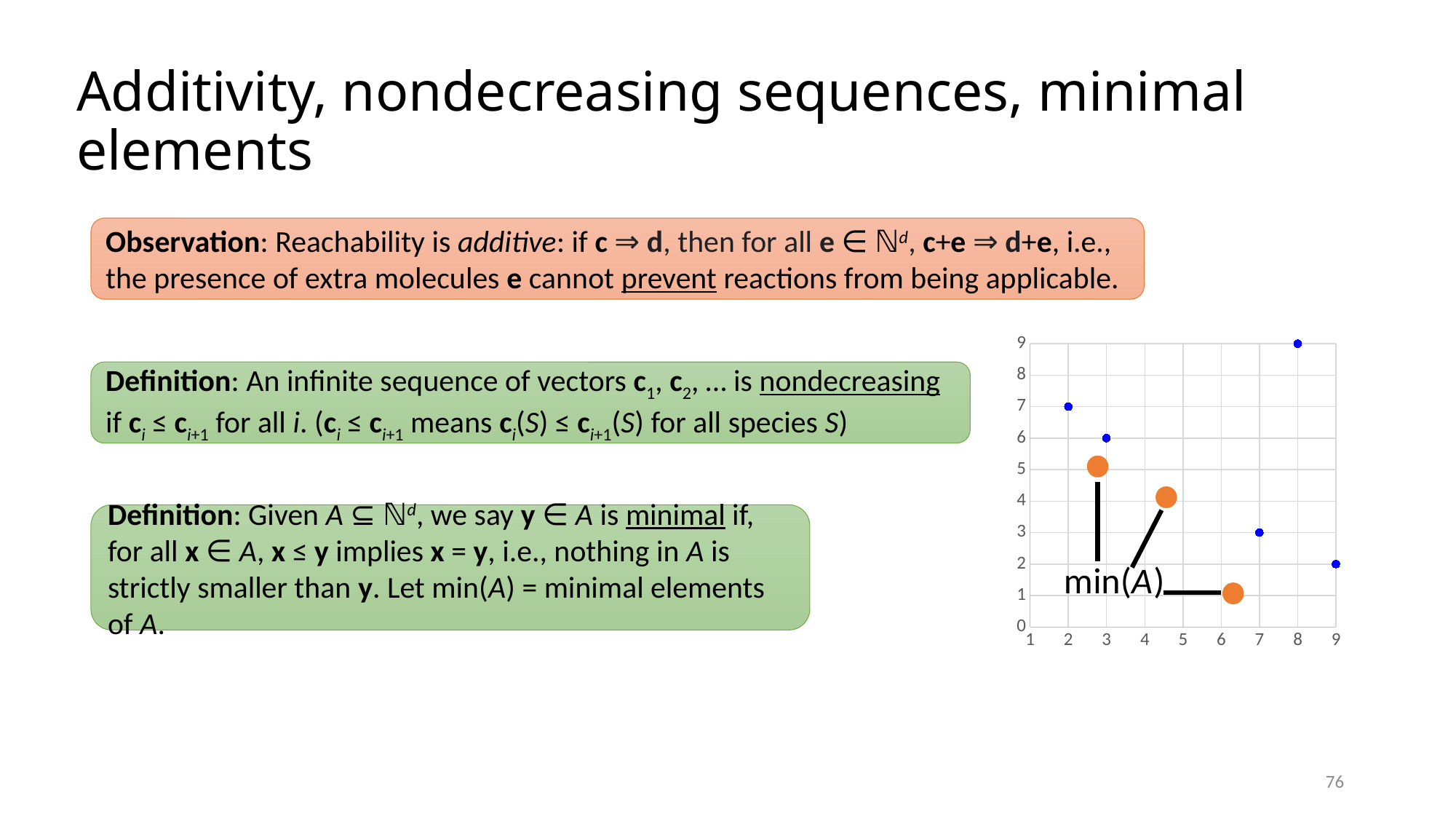
What is the y value of the blue point at x = 7? 3 What kind of chart is shown on the right of the slide? scatter chart What is the y value of the blue point at x = 9? 2 How many blue points are plotted on the chart? 5 Is the y value of the blue point at x = 3 greater or less than 5? greater What is the y value of the blue point at x = 8? 9 What label is written next to the orange points on the chart? min(A) Which blue point has the highest y value? the point at x = 8 How many orange points are plotted on the chart? 3 Which blue point has the lowest y value? the point at x = 9 What is the y value of the blue point at x = 2? 7 What is the difference in y value between the blue points at x = 2 and x = 7? 4